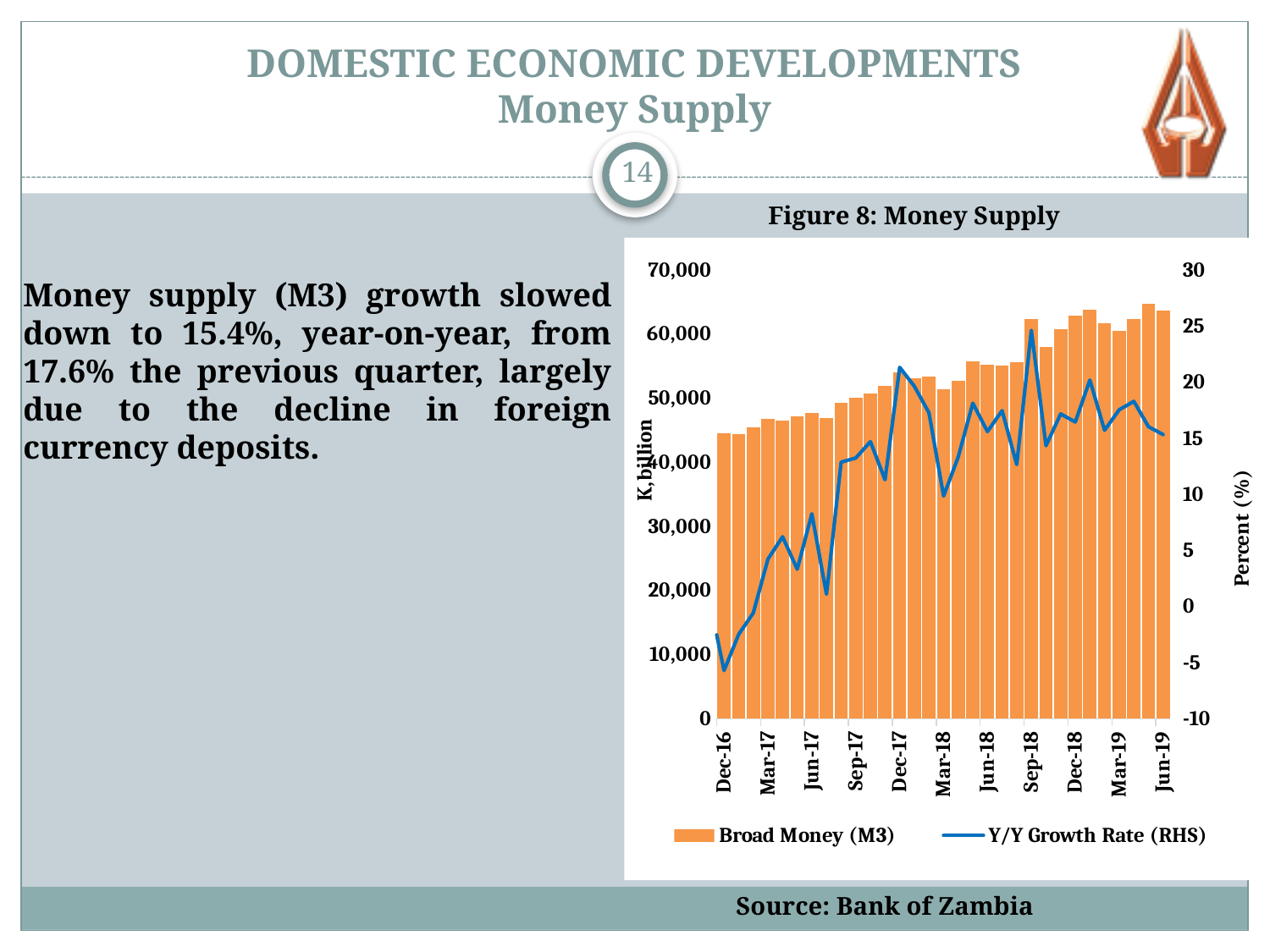
Is the Broad Money (M3) value for Dec-16 greater or less than 50,000? less Which series in Figure 8 is plotted on the right-hand axis? Y/Y Growth Rate (RHS) Is the Broad Money (M3) value for Jun-19 greater or less than 60,000? greater What kind of chart is Figure 8: Money Supply? A combination bar and line chart Is the Y/Y Growth Rate for Jun-19 greater or less than 20? less Does Broad Money (M3) generally rise or fall from Dec-16 to Jun-19? rise How many series does the legend of Figure 8 list? 2 Which series in Figure 8 is plotted as bars? Broad Money (M3) At which labelled month does the Y/Y Growth Rate reach its highest point? Sep-18 Is the Broad Money (M3) value for Jun-19 larger or smaller than the value for Dec-16? larger